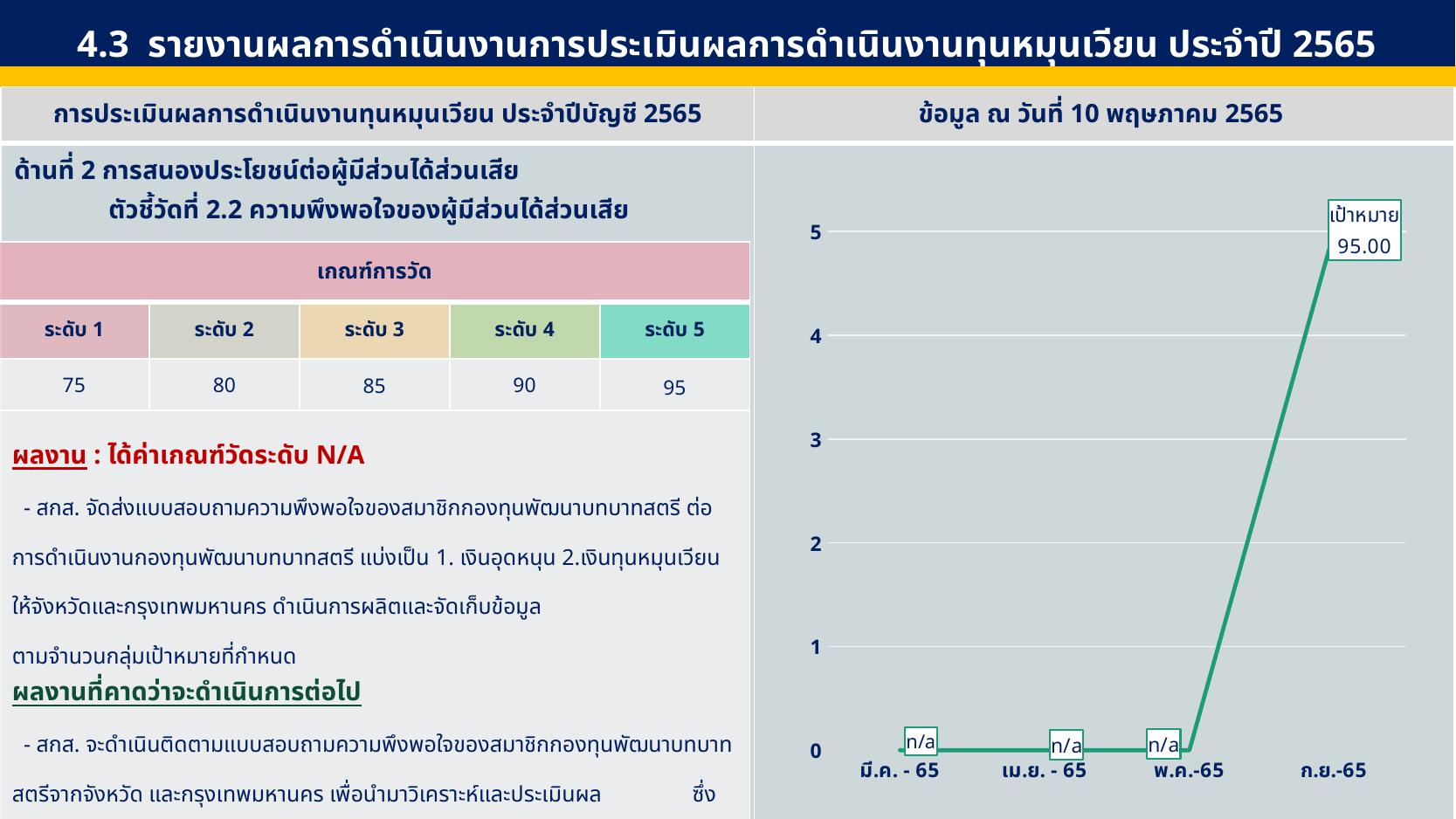
What numeric data label is shown for ก.ย.-65 in the chart? 95.00 What kind of chart is shown on the right side of the slide? line chart What data label is shown for มี.ค. - 65 in the chart? n/a Does the line rise or fall from พ.ค.-65 to ก.ย.-65? rise How many categories in the chart are labelled n/a? 3 What word appears above the 95.00 data label at ก.ย.-65? เป้าหมาย How many categories are shown on the x axis of the chart? 4 Which category has the highest point on the line in the chart? ก.ย.-65 Is the plotted point for ก.ย.-65 greater or less than 4 on the y axis? greater What data label is shown for พ.ค.-65 in the chart? n/a What is the highest tick value shown on the y axis of the chart? 5 What is the first category on the x axis of the chart? มี.ค. - 65